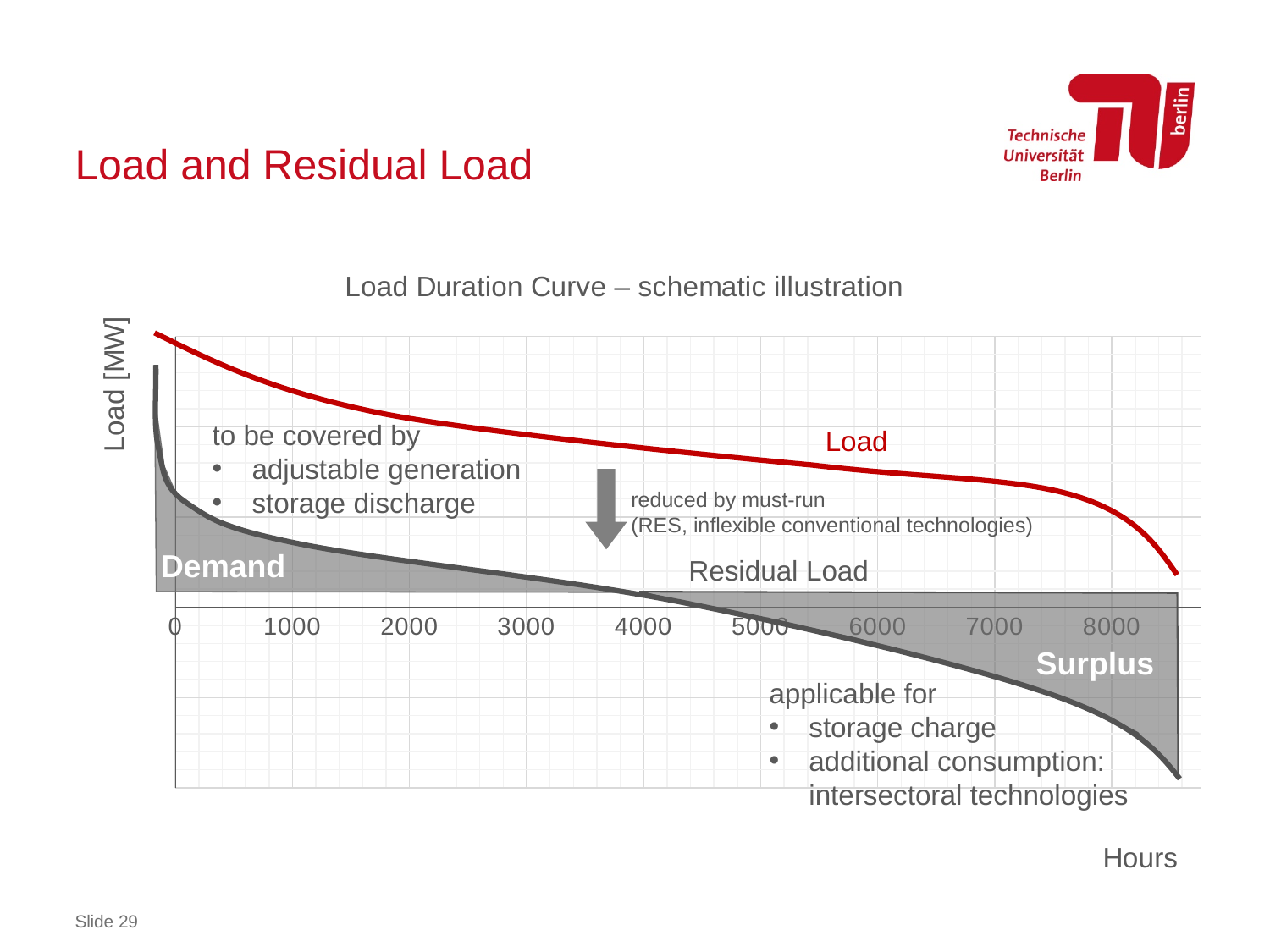
Which curve lies higher on the chart, Load or Residual Load? Load What is the shaded area below the zero line labelled? Surplus Does the Residual Load curve rise or fall as hours increase along the x axis? fall What kind of chart is shown on the slide? line chart How many curves are plotted on the chart? 2 Is the Residual Load curve above or below zero at 2000 hours? above What is the label of the x axis? Hours What is the highest tick value shown on the x axis? 8000 What is the title of the chart? Load Duration Curve – schematic illustration Is the Residual Load curve above or below zero at 7000 hours? below What is the shaded area above the zero line labelled? Demand Does the Load curve rise or fall as hours increase along the x axis? fall